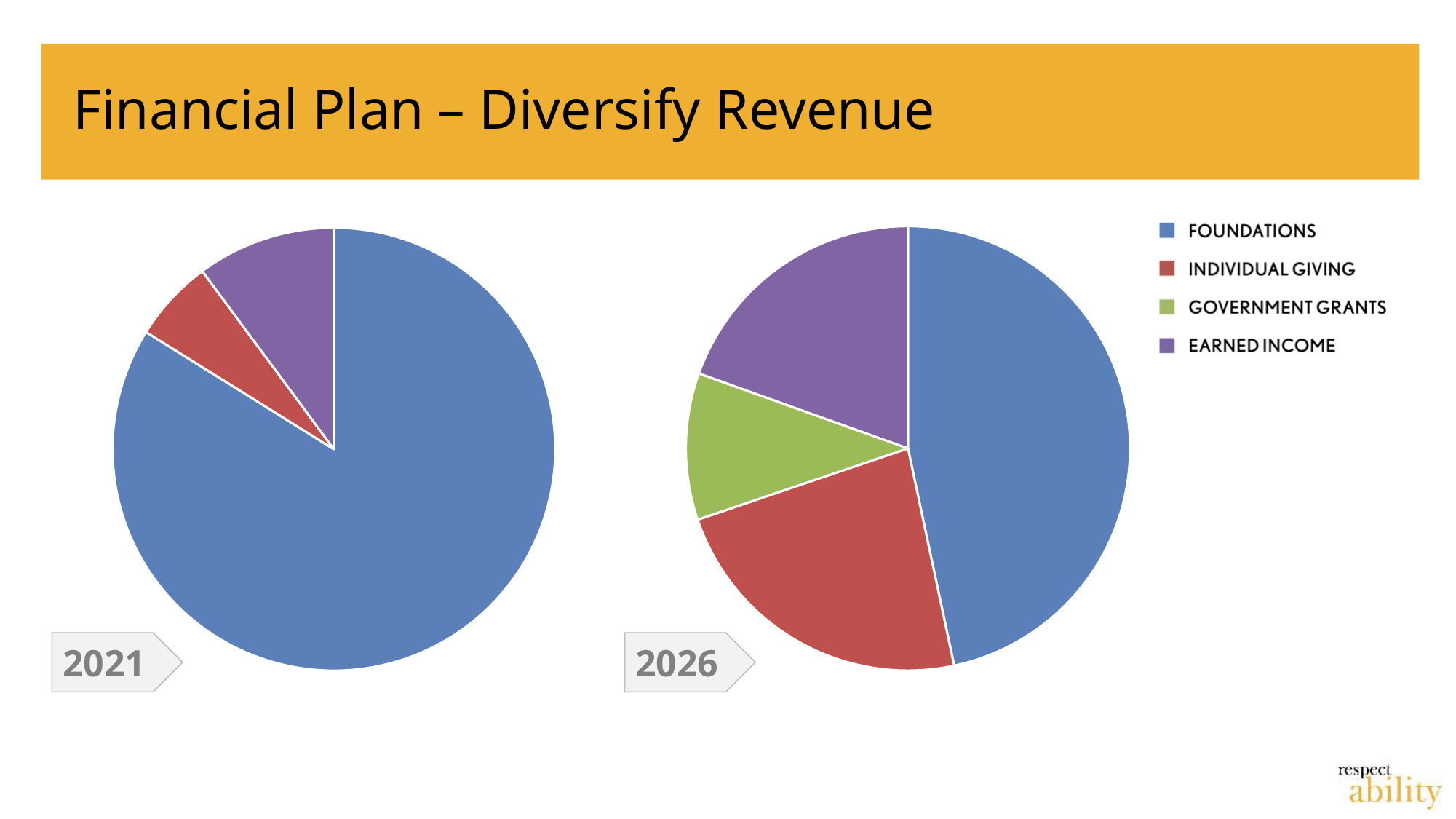
In the 2021 pie chart, which is larger: Earned Income or Individual Giving? Earned Income Which legend category does not appear in the 2021 pie chart? Government Grants In the 2026 pie chart, which category has the smallest slice? Government Grants In the 2021 pie chart, which category has the largest slice? Foundations In the 2021 pie chart, which category has the smallest slice? Individual Giving What colour represents Earned Income in the pie charts? purple How many slices does the 2026 pie chart have? 4 How many entries does the legend list? 4 What kind of chart is used for the 2021 chart? pie chart How many slices does the 2021 pie chart have? 3 In the 2026 pie chart, which category has the largest slice? Foundations In the 2026 pie chart, which is larger: Foundations or Individual Giving? Foundations